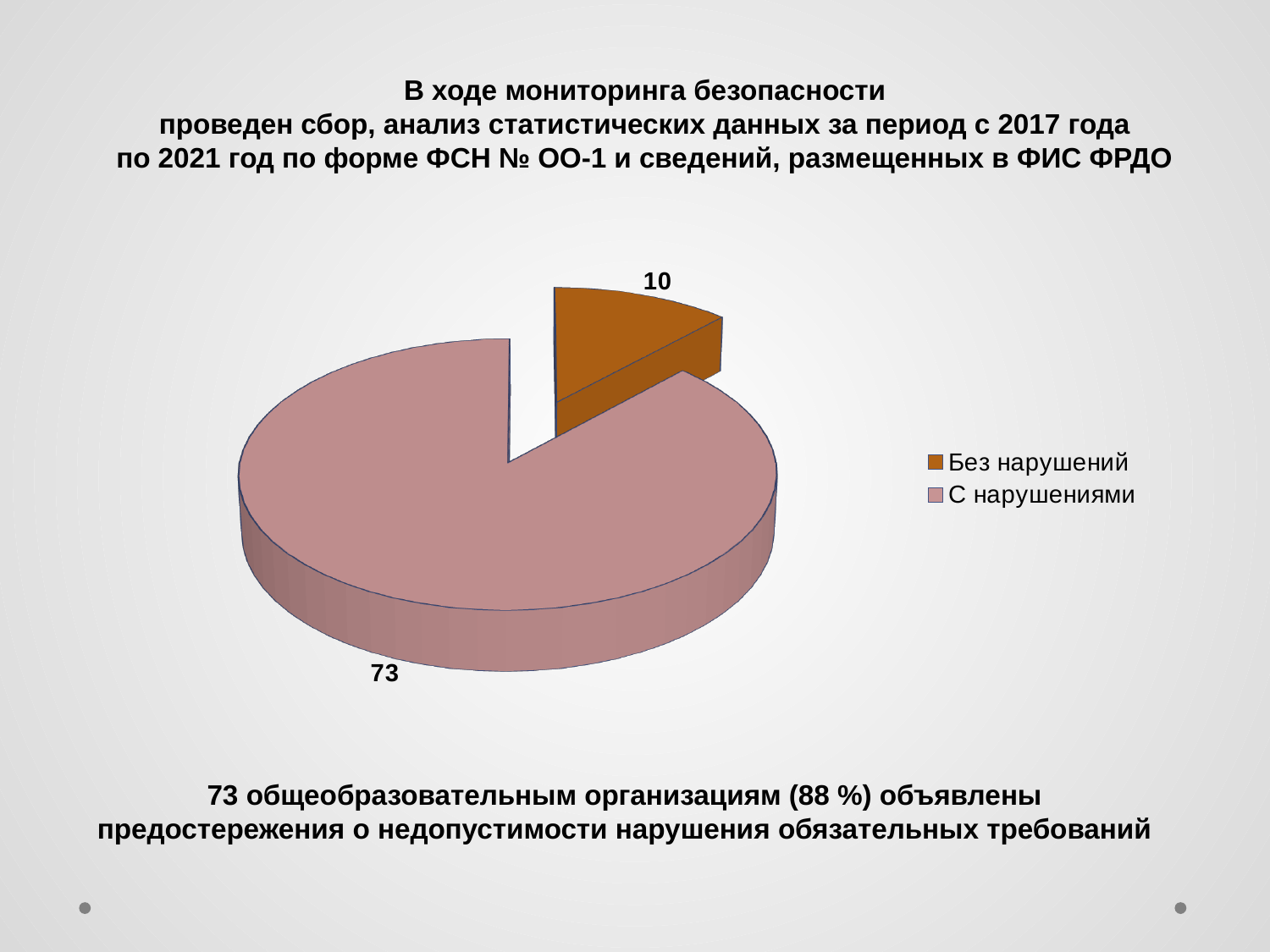
What is the total of the two values shown in the pie chart? 83 What colour is the "Без нарушений" slice? orange Which category has the smallest slice of the pie? Без нарушений What is the difference between the values for "С нарушениями" and "Без нарушений"? 63 What kind of chart is shown on the slide? pie chart What is the value for "С нарушениями"? 73 What share of the pie does the "С нарушениями" slice represent, as stated on the slide? 88 % What is the value for "Без нарушений"? 10 Which category has the largest slice of the pie? С нарушениями Which is larger, the value for "Без нарушений" or the value for "С нарушениями"? С нарушениями How many slices does the pie chart have? 2 How many entries does the legend list? 2